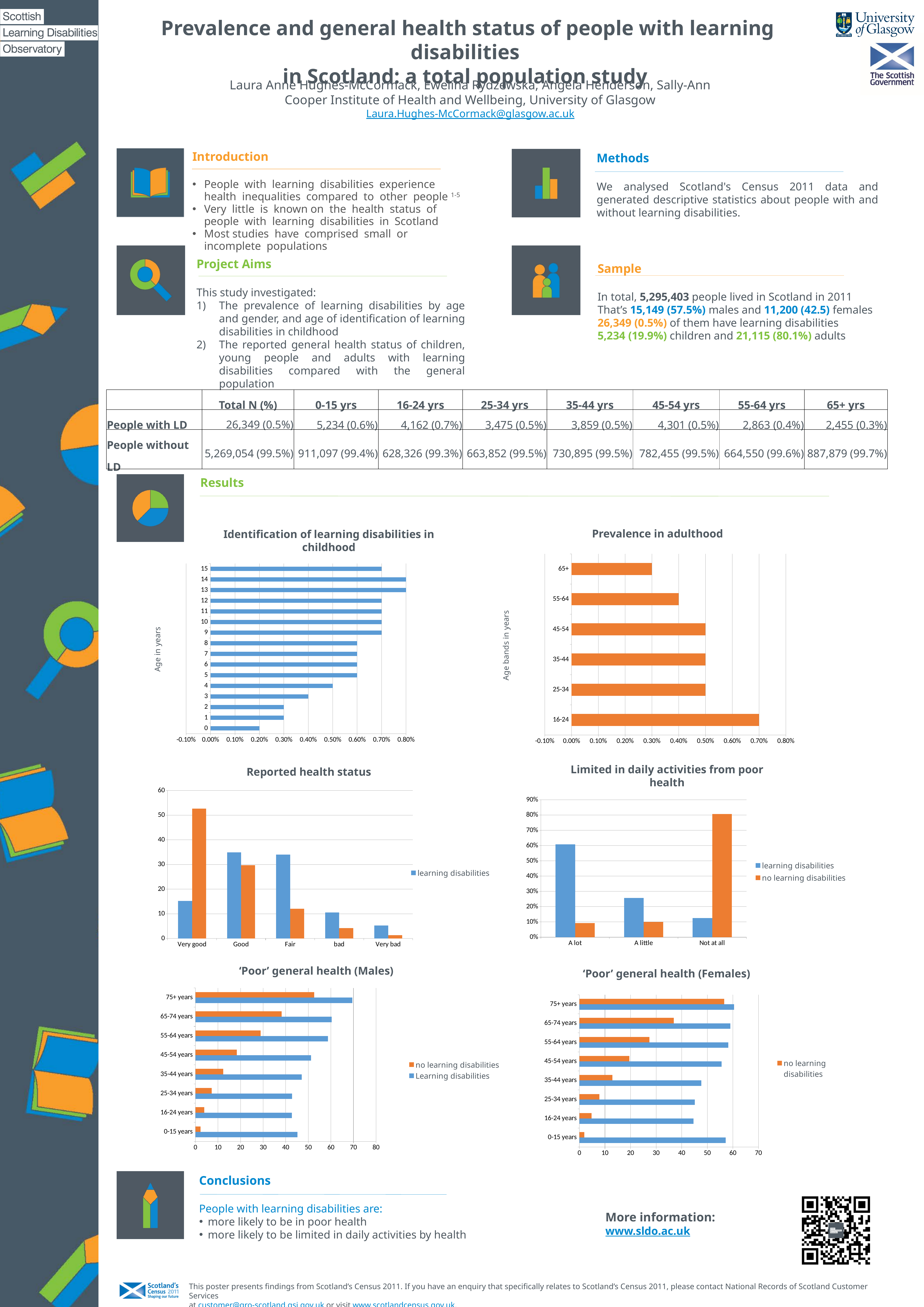
In the 'Limited in daily activities from poor health' chart, how many series does the legend list? 2 In the 'Prevalence in adulthood' chart, which age band has the highest prevalence? 16-24 In the 'Identification of learning disabilities in childhood' chart, what is the value for age 0? 0.20% What kind of chart is the 'Identification of learning disabilities in childhood' chart? bar chart In the 'Identification of learning disabilities in childhood' chart, how many ages are plotted? 16 In the 'Identification of learning disabilities in childhood' chart, which age has the lowest value? 0 In the 'Limited in daily activities from poor health' chart, is the 'Not at all' value for no learning disabilities greater or less than 70%? greater In the 'Prevalence in adulthood' chart, what is the value for the 16-24 age band? 0.70% In the 'Prevalence in adulthood' chart, what is the difference between the 16-24 and 65+ age bands? 0.40% In the ''Poor' general health (Males)' chart, how many age groups are plotted? 8 In the 'Limited in daily activities from poor health' chart, for 'A lot', which series has the larger value: learning disabilities or no learning disabilities? learning disabilities In the 'Prevalence in adulthood' chart, which age band has the lowest prevalence? 65+